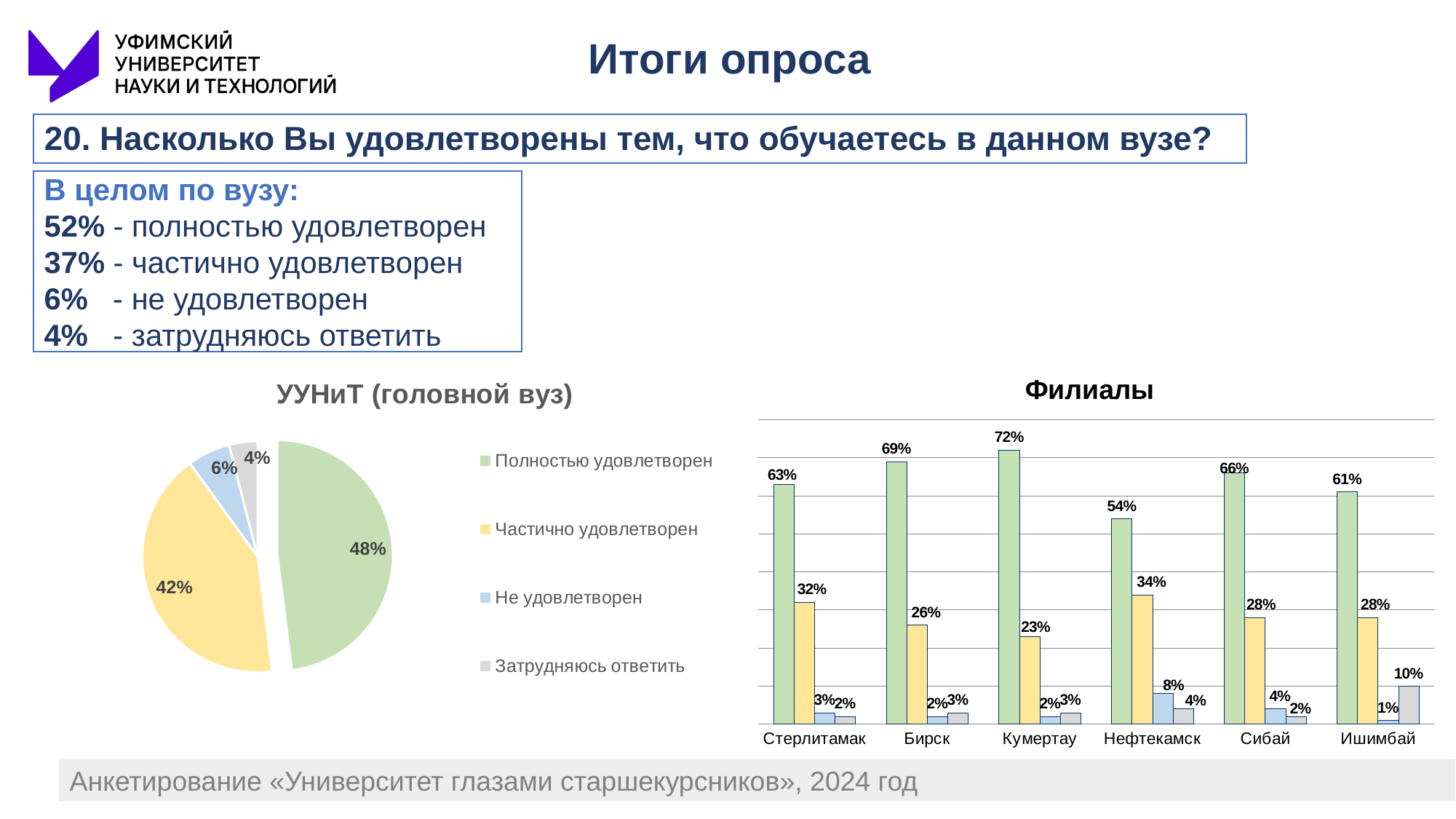
What kind of chart is the 'УУНиТ (головной вуз)' chart? pie chart In the 'Филиалы' bar chart, what is the difference between the green 'Полностью удовлетворен' bars for Бирск and Стерлитамак? 6% How many entries does the legend of the 'УУНиТ (головной вуз)' pie chart list? 4 In the 'Филиалы' bar chart, which is larger: the yellow 'Частично удовлетворен' bar for Нефтекамск or for Кумертау? Нефтекамск In the 'УУНиТ (головной вуз)' pie chart, what is the value for 'Не удовлетворен'? 6% In the 'Филиалы' bar chart, which branch has the highest green 'Полностью удовлетворен' bar? Кумертау In the 'Филиалы' bar chart, which branch has the lowest green 'Полностью удовлетворен' bar? Нефтекамск In the 'УУНиТ (головной вуз)' pie chart, what share is 'Полностью удовлетворен'? 48% In the 'Филиалы' bar chart, what is the value of the green 'Полностью удовлетворен' bar for Кумертау? 72% In the 'УУНиТ (головной вуз)' pie chart, which category has the smallest slice? Затрудняюсь ответить What kind of chart is the 'Филиалы' chart? bar chart How many branches are shown on the x axis of the 'Филиалы' bar chart? 6